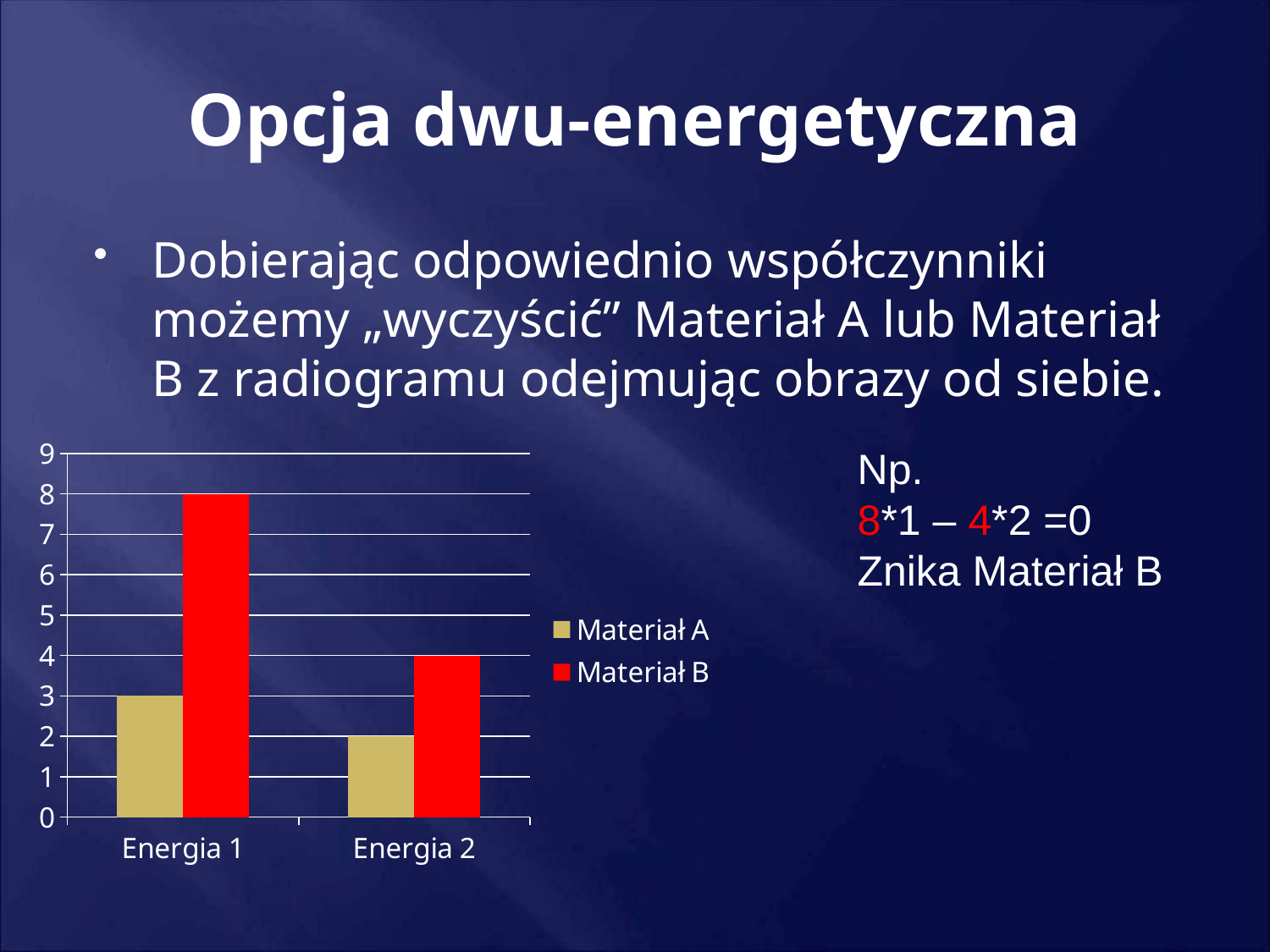
What is the value for Materiał B at Energia 2? 4 Does the value for Materiał B fall or rise from Energia 1 to Energia 2? fall Is the value for Materiał B at Energia 1 greater or less than 5? greater How many categories are shown on the x axis of the chart? 2 What is the difference between the Materiał B values at Energia 1 and Energia 2? 4 What kind of chart is shown on the slide? bar chart Which series is shown in red in the chart legend? Materiał B What is the value for Materiał A at Energia 2? 2 What is the value for Materiał B at Energia 1? 8 Which series has the higher value at Energia 1, Materiał A or Materiał B? Materiał B What is the value for Materiał A at Energia 1? 3 How many series does the chart legend list? 2